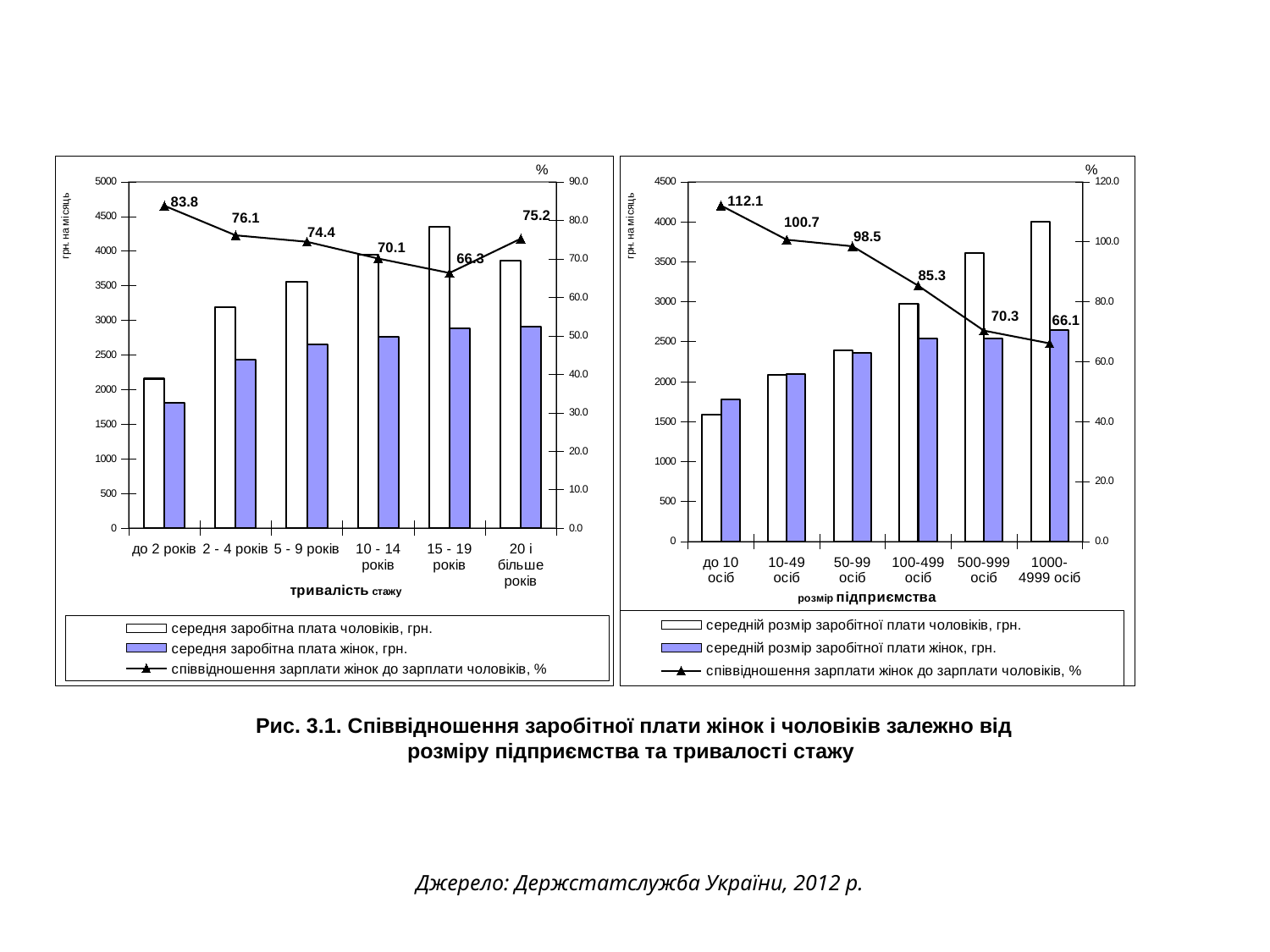
In the left chart (тривалість стажу), what is the ratio of women's to men's wages (%) for '15 - 19 років'? 66.3 In the left chart (тривалість стажу), how many categories are shown on the x axis? 6 In the right chart (розмір підприємства), is the ratio for '500-999 осіб' larger or smaller than the ratio for '1000-4999 осіб'? larger In the right chart (розмір підприємства), what is the ratio of women's to men's wages (%) for 'до 10 осіб'? 112.1 In the right chart (розмір підприємства), which category has the highest ratio of women's to men's wages? до 10 осіб In the left chart (тривалість стажу), is the men's average wage for '15 - 19 років' greater or less than 4000? greater In the right chart (розмір підприємства), does the ratio of women's to men's wages rise or fall as enterprise size increases along the x axis? fall In the left chart (тривалість стажу), what is the ratio of women's to men's wages (%) for the category 'до 2 років'? 83.8 In the right chart (розмір підприємства), what is the ratio of women's to men's wages (%) for '100-499 осіб'? 85.3 In the left chart (тривалість стажу), what is the difference between the ratio for 'до 2 років' and the ratio for '20 і більше років'? 8.6 How many series does the legend of the right chart (розмір підприємства) list? 3 In the left chart (тривалість стажу), which category has the lowest ratio of women's to men's wages? 15 - 19 років